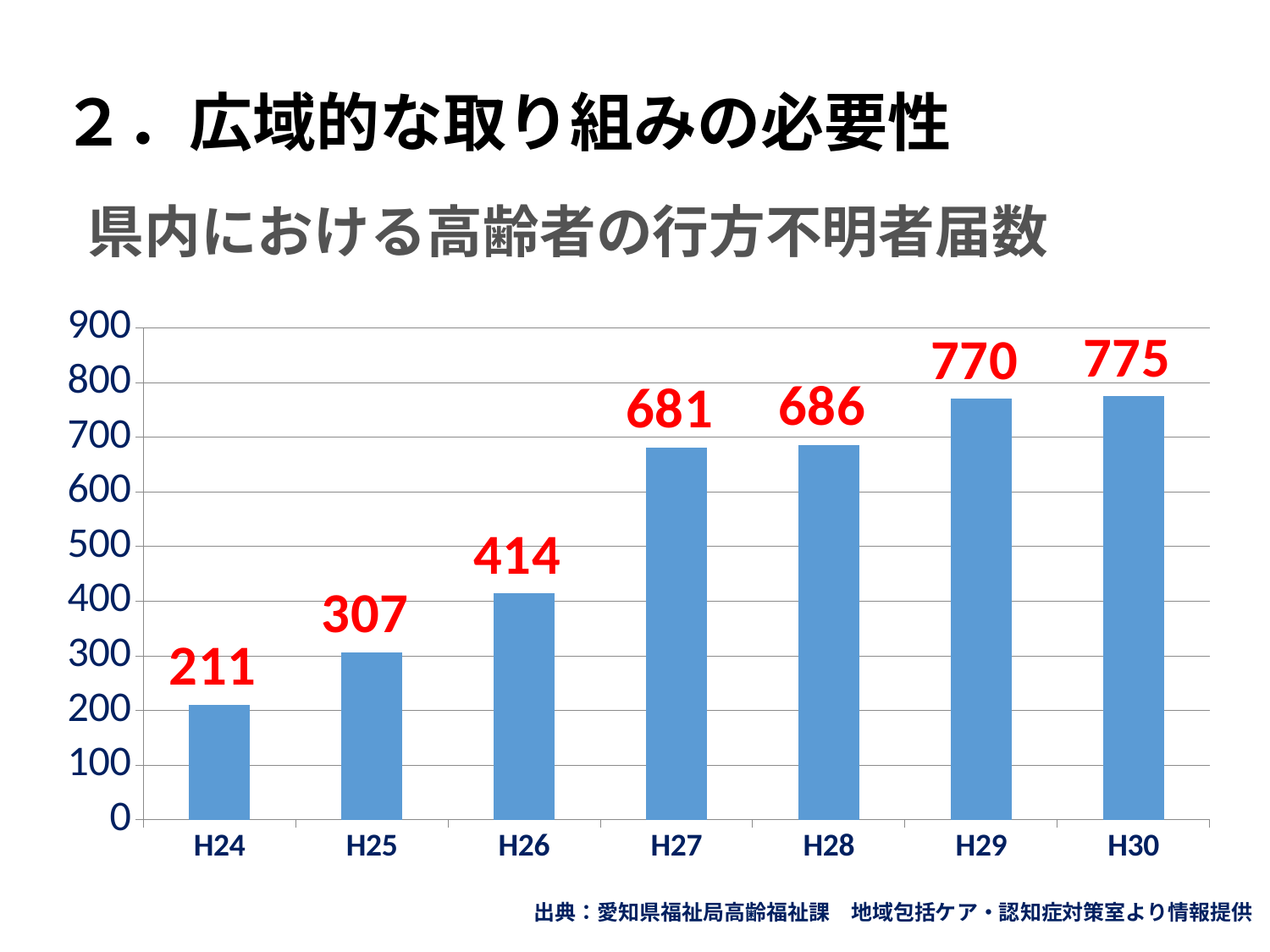
Which year has the highest value? H30 What is the difference between the values for H26 and H25? 107 What kind of chart is shown on the slide? bar chart Do the values rise or fall from H24 to H30? rise Is the value for H28 greater or less than 600? greater How many years are shown on the x axis? 7 What is the difference between the values for H30 and H24? 564 Which year has the lowest value? H24 What is the value for H24? 211 What is the value for H27? 681 What is the value for H30? 775 Which is larger, the value for H26 or the value for H27? H27